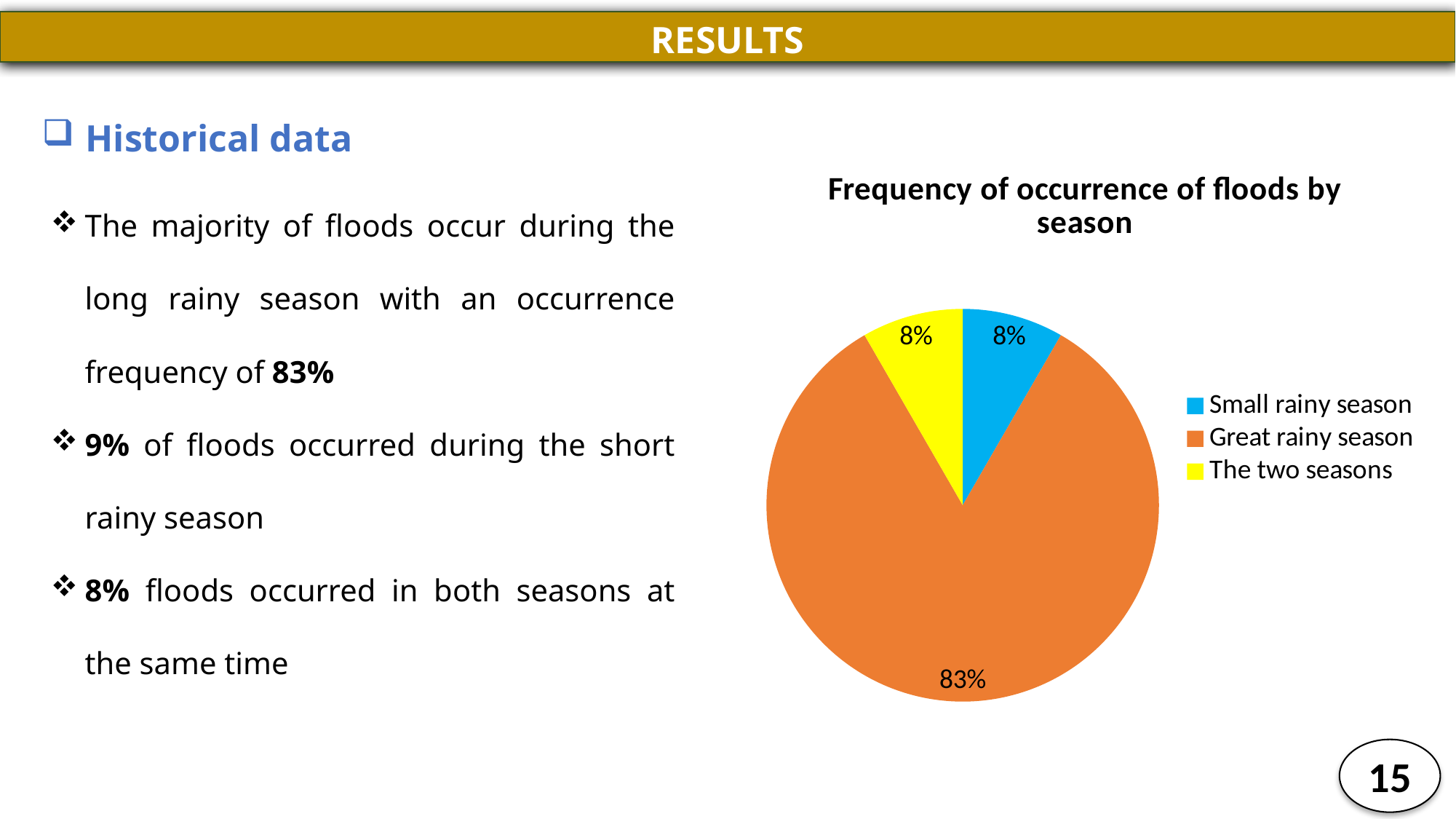
What is the title of the chart? Frequency of occurrence of floods by season What share of floods occurred during the Great rainy season according to the pie chart? 83% Which season has the largest share of flood occurrences in the pie chart? Great rainy season What share of floods occurred in The two seasons according to the pie chart? 8% Which colour represents the Great rainy season in the pie chart? orange How many categories does the pie chart show? 3 What share of floods occurred during the Small rainy season according to the pie chart? 8% What type of chart is shown on the slide? pie chart How many entries are listed in the chart legend? 3 What is the difference in percentage points between the Great rainy season and the Small rainy season shares? 75 Which has a larger share in the pie chart, the Great rainy season or The two seasons? Great rainy season